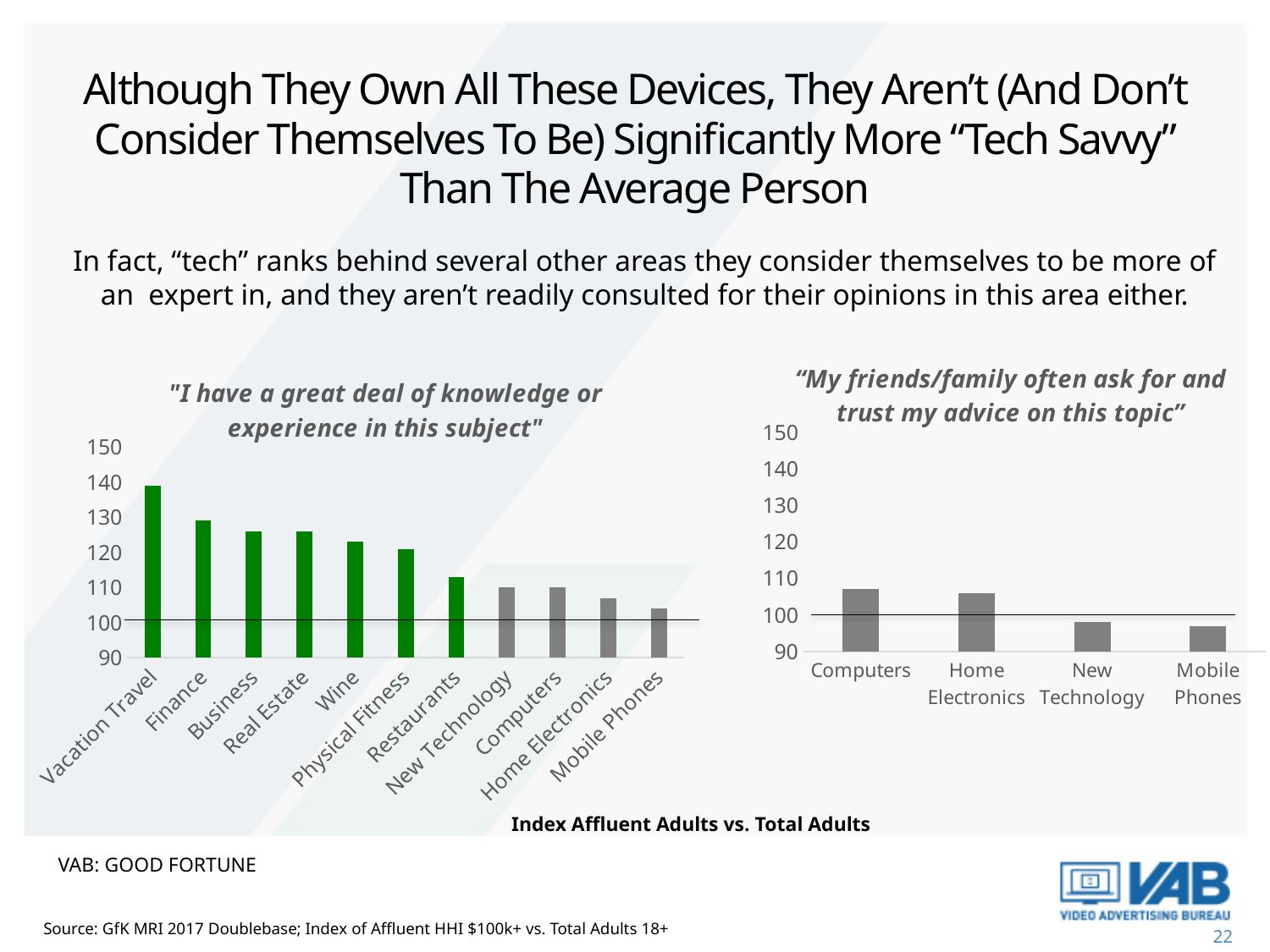
In the right chart ("My friends/family often ask for and trust my advice on this topic"), is the value for New Technology greater or less than 100? less In the left chart ("I have a great deal of knowledge or experience in this subject"), what colour is the bar for Vacation Travel? Green In the left chart ("I have a great deal of knowledge or experience in this subject"), which is larger, the value for Finance or the value for Wine? Finance In the left chart ("I have a great deal of knowledge or experience in this subject"), which category has the highest value? Vacation Travel In the left chart ("I have a great deal of knowledge or experience in this subject"), which category has the lowest value? Mobile Phones What kind of chart is the left chart titled "I have a great deal of knowledge or experience in this subject"? Bar chart In the right chart ("My friends/family often ask for and trust my advice on this topic"), how many categories are shown? 4 In the right chart ("My friends/family often ask for and trust my advice on this topic"), which is larger, the value for Computers or the value for Mobile Phones? Computers In the left chart ("I have a great deal of knowledge or experience in this subject"), do the values rise or fall moving from left to right along the x axis? fall In the left chart ("I have a great deal of knowledge or experience in this subject"), how many categories are shown? 11 In the left chart ("I have a great deal of knowledge or experience in this subject"), is the value for Restaurants greater or less than 120? less In the left chart ("I have a great deal of knowledge or experience in this subject"), is the value for Vacation Travel greater or less than 130? greater